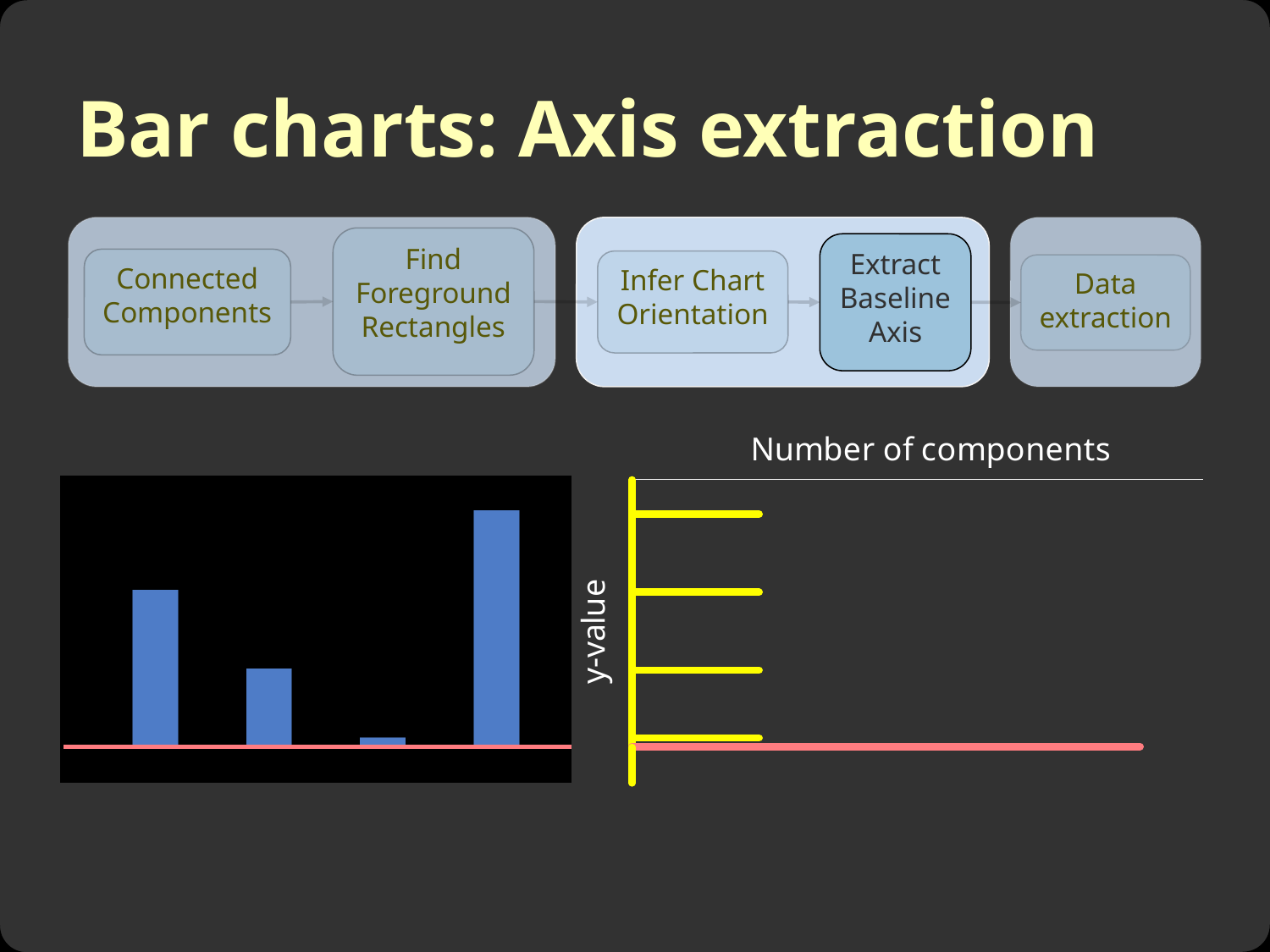
In the bar chart on the left of the slide, which bar is the tallest? the fourth (rightmost) bar What kind of chart is shown on the left of the slide (the one with the black background)? bar chart What colour are the bars in the bar chart on the left of the slide? blue How many bars are plotted in the bar chart on the left of the slide? 4 In the bar chart on the left of the slide, is the fourth bar or the first bar taller? the fourth bar In the bar chart on the left of the slide, is the second bar or the third bar taller? the second bar In the bar chart on the left of the slide, which bar is the shortest? the third bar What is the title shown above the axis diagram on the right of the slide? Number of components In the bar chart on the left of the slide, is the first bar or the second bar taller? the first bar